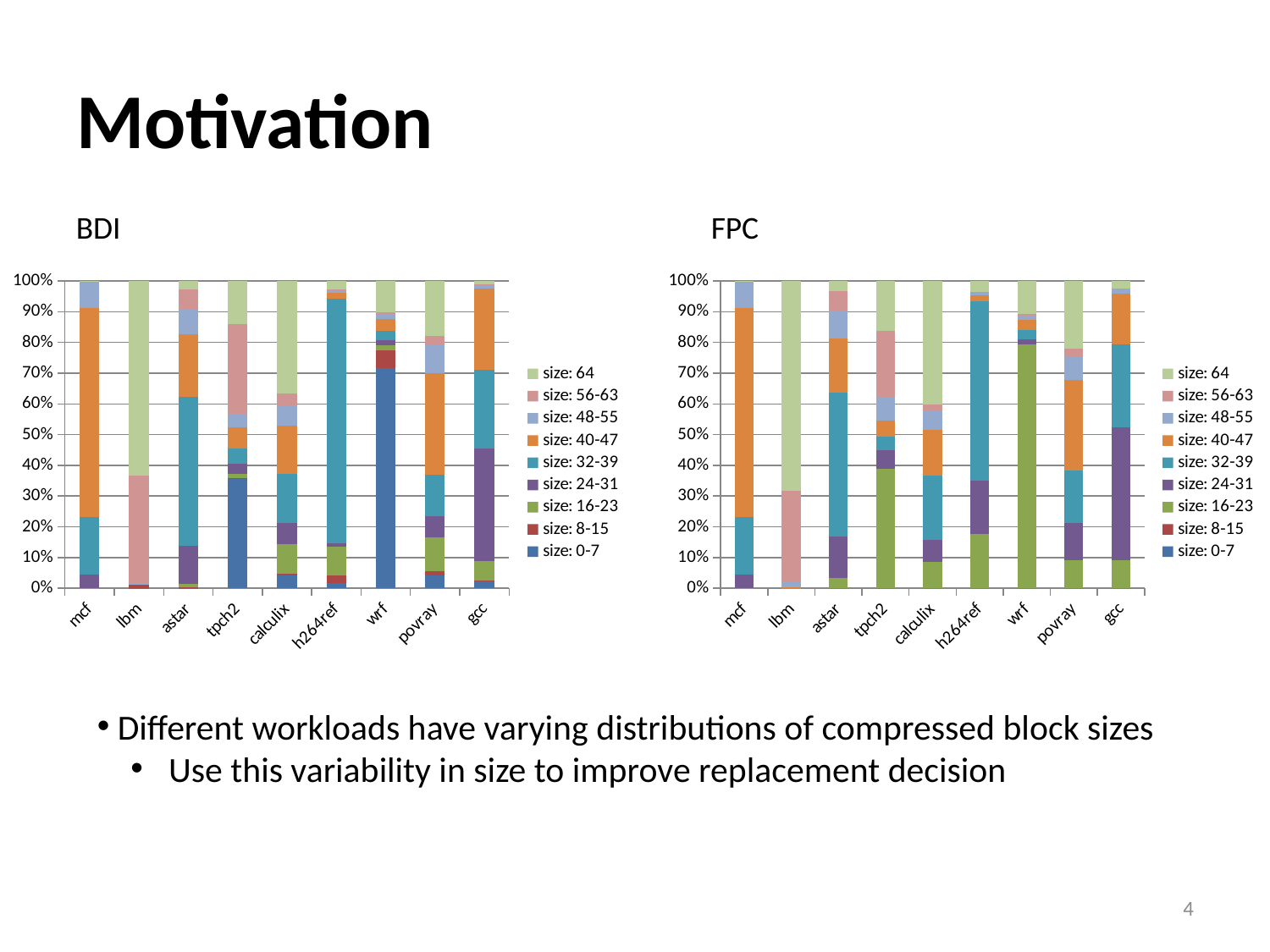
How many series does the legend of the BDI chart list? 9 In the FPC chart, is the size: 16-23 share for wrf greater or less than 70%? greater What kind of chart is the BDI chart? stacked bar chart How many workload categories are shown on the x axis of the FPC chart? 9 In the FPC chart, is the size: 64 share larger for lbm or for mcf? lbm What are the titles of the two charts on the slide, from left to right? BDI and FPC In the BDI chart, is the size: 64 share for lbm greater or less than 50%? greater In the BDI chart, is the size: 40-47 share for mcf greater or less than 60%? greater In the BDI chart, which workload has the largest size: 64 share? lbm In the FPC chart, which workload has the largest size: 64 share? lbm In the BDI chart, is the size: 0-7 share larger for wrf or for tpch2? wrf